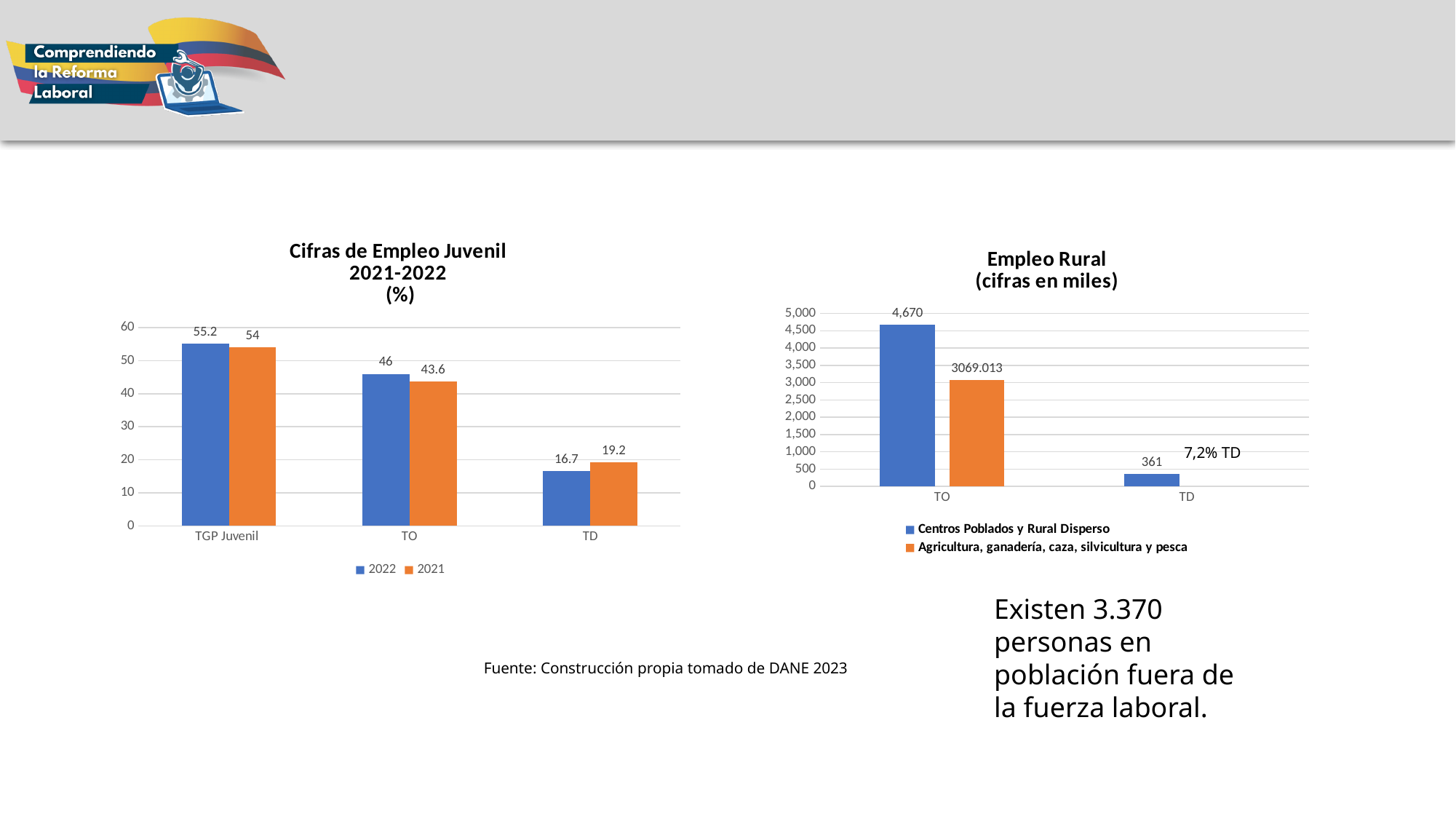
What kind of chart is the 'Empleo Rural (cifras en miles)' chart? Bar chart In the 'Empleo Rural (cifras en miles)' chart, what is the value for Agricultura, ganadería, caza, silvicultura y pesca at TO? 3069.013 How many categories are shown on the x axis of the 'Cifras de Empleo Juvenil 2021-2022 (%)' chart? 3 In the 'Empleo Rural (cifras en miles)' chart, what is the value for Centros Poblados y Rural Disperso at TO? 4,670 In the 'Empleo Rural (cifras en miles)' chart, what is the value for Centros Poblados y Rural Disperso at TD? 361 In the 'Cifras de Empleo Juvenil 2021-2022 (%)' chart, which is larger for TD: the 2022 value or the 2021 value? 2021 In the 'Cifras de Empleo Juvenil 2021-2022 (%)' chart, what is the 2021 value for TD? 19.2 How many series does the legend of the 'Cifras de Empleo Juvenil 2021-2022 (%)' chart list? 2 In the 'Cifras de Empleo Juvenil 2021-2022 (%)' chart, what is the difference between the 2022 and 2021 values for TGP Juvenil? 1.2 In the 'Cifras de Empleo Juvenil 2021-2022 (%)' chart, what is the 2022 value for TGP Juvenil? 55.2 In the 'Cifras de Empleo Juvenil 2021-2022 (%)' chart, which category has the lowest 2022 value? TD In the 'Cifras de Empleo Juvenil 2021-2022 (%)' chart, what is the 2021 value for TO? 43.6